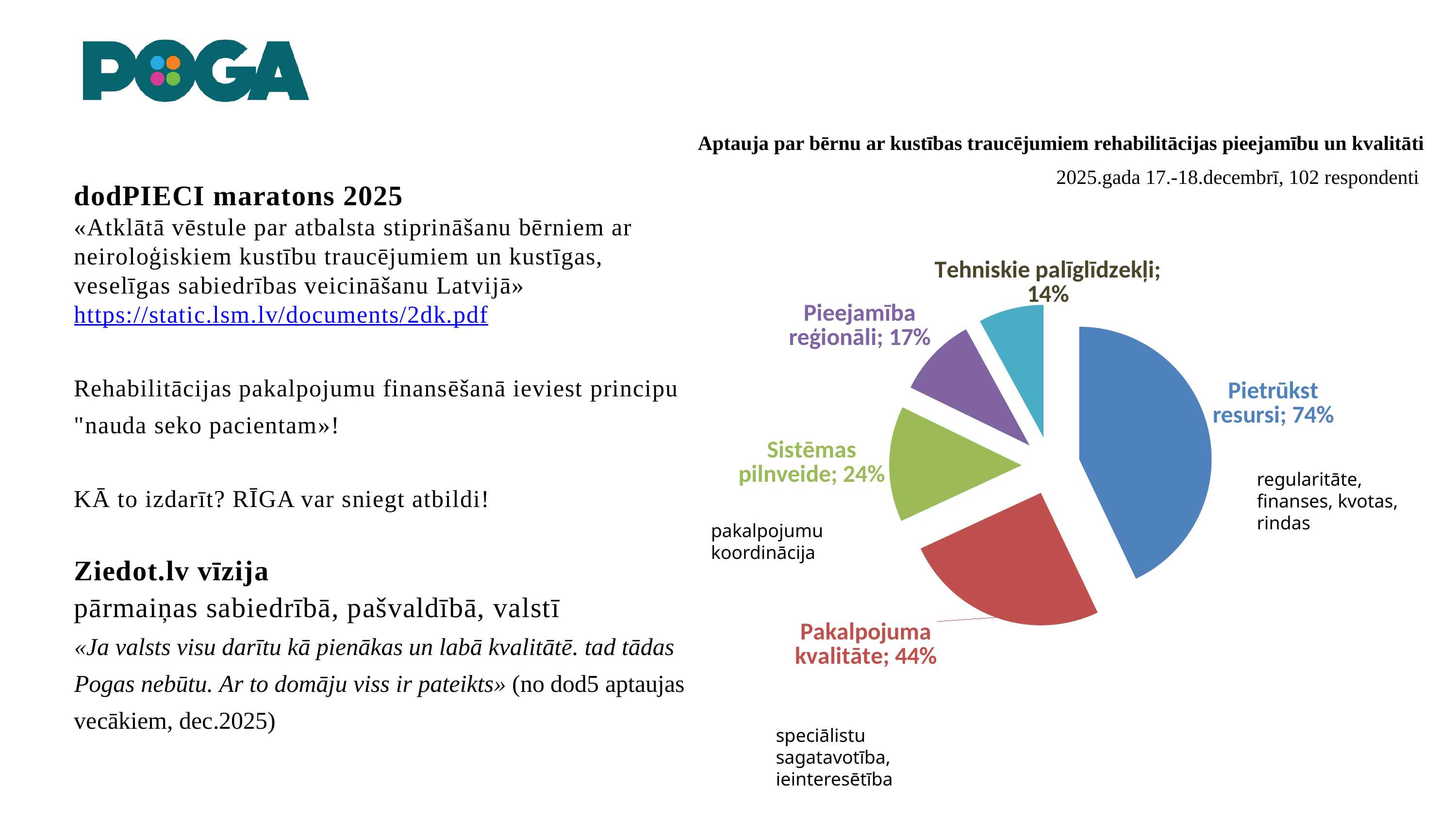
What is the difference between the values for "Pietrūkst resursi" and "Pakalpojuma kvalitāte"? 30% How many respondents does the chart subtitle say took part in the survey? 102 What is the value shown for "Pieejamība reģionāli"? 17% Which category has the lowest value in the pie chart? Tehniskie palīglīdzekļi What kind of chart is shown on the slide? Pie chart What is the value shown for "Pakalpojuma kvalitāte"? 44% Which is larger, the value for "Sistēmas pilnveide" or the value for "Pieejamība reģionāli"? Sistēmas pilnveide How many categories are shown in the pie chart? 5 What is the value shown for "Tehniskie palīglīdzekļi"? 14% What is the value shown for "Sistēmas pilnveide"? 24% What is the value shown for "Pietrūkst resursi"? 74% Which category has the highest value in the pie chart? Pietrūkst resursi